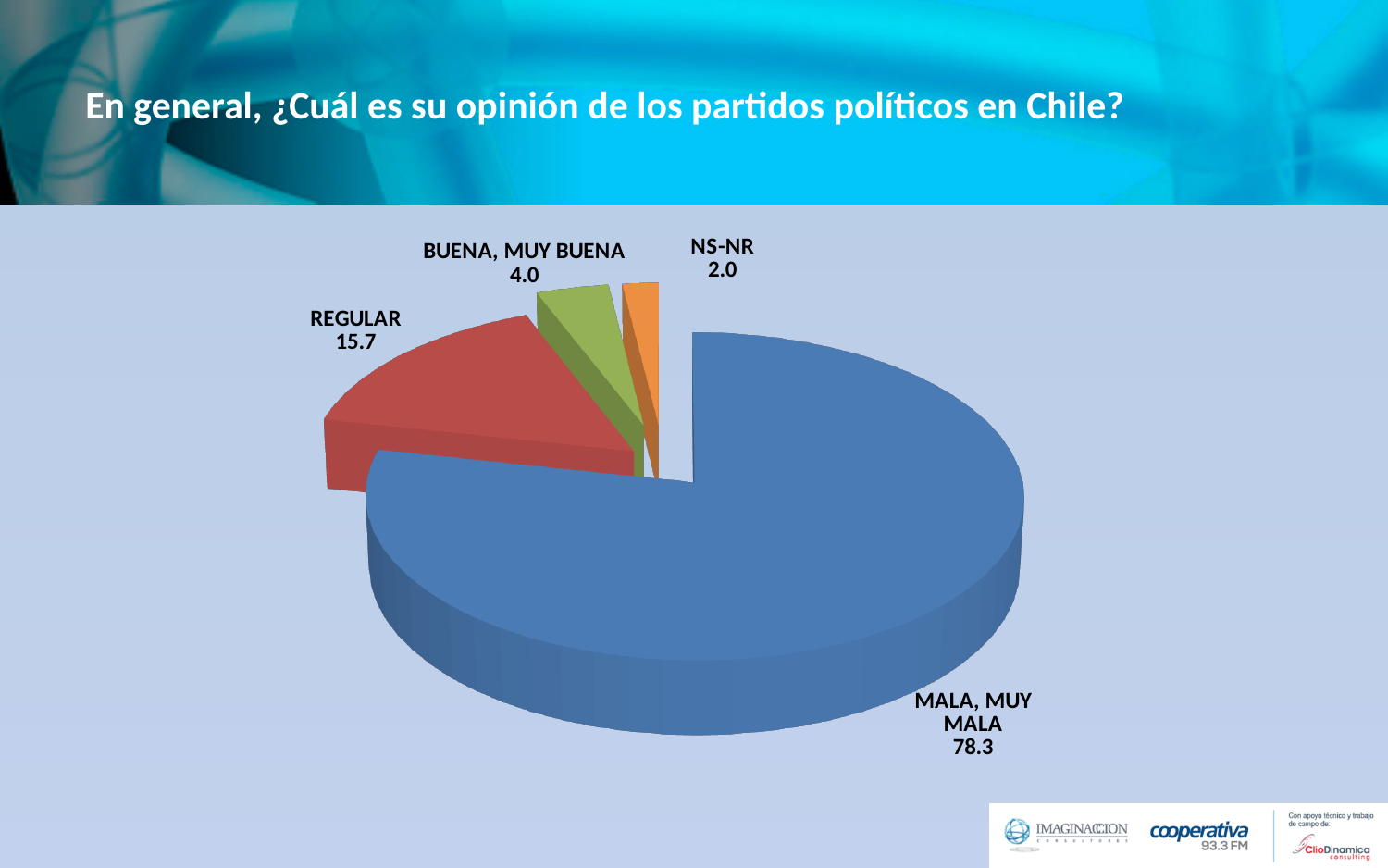
What kind of chart is shown on the slide? Pie chart What is the difference between the values for MALA, MUY MALA and REGULAR? 62.6 What is the value for NS-NR? 2.0 What is the value for BUENA, MUY BUENA? 4.0 How many categories are shown in the pie chart? 4 What is the value for REGULAR? 15.7 Which is larger, the value for REGULAR or the value for BUENA, MUY BUENA? REGULAR What is the difference between the values for BUENA, MUY BUENA and NS-NR? 2.0 What is the value for MALA, MUY MALA? 78.3 Which category has the smallest slice? NS-NR Which category has the largest slice? MALA, MUY MALA What is the title of the slide? En general, ¿Cuál es su opinión de los partidos políticos en Chile?